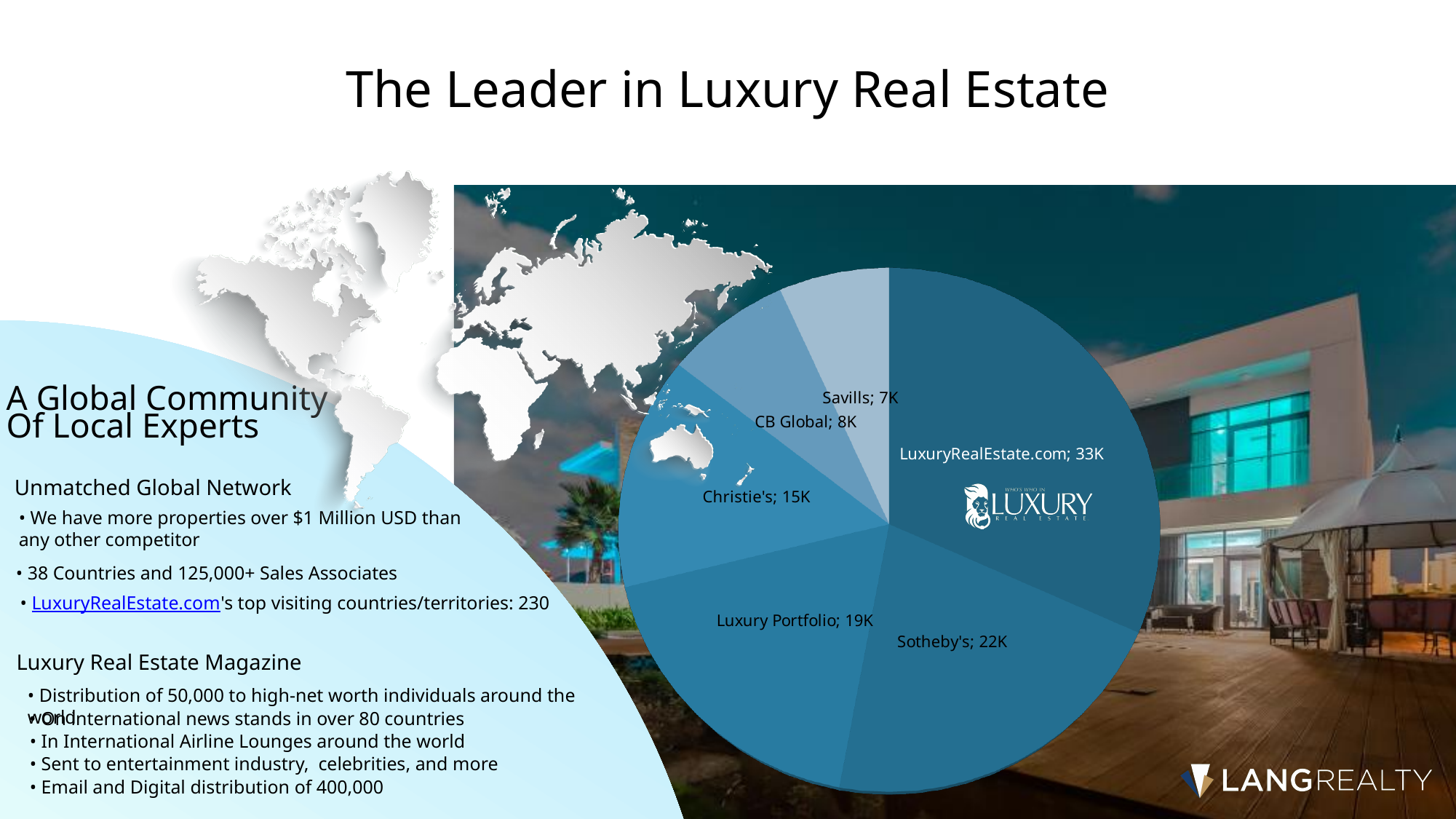
Which slice of the pie chart has the smallest value? Savills How many slices does the pie chart have? 6 Which has the larger value in the pie chart, CB Global or Savills? CB Global Which slice of the pie chart has the largest value? LuxuryRealEstate.com What value is shown for LuxuryRealEstate.com in the pie chart? 33K What value is shown for Sotheby's in the pie chart? 22K What value is shown for Savills in the pie chart? 7K What type of chart is shown on the slide? Pie chart What is the difference between the values for LuxuryRealEstate.com and Sotheby's in the pie chart? 11K What is the difference between the values for Luxury Portfolio and Christie's in the pie chart? 4K What value is shown for Christie's in the pie chart? 15K What value is shown for Luxury Portfolio in the pie chart? 19K